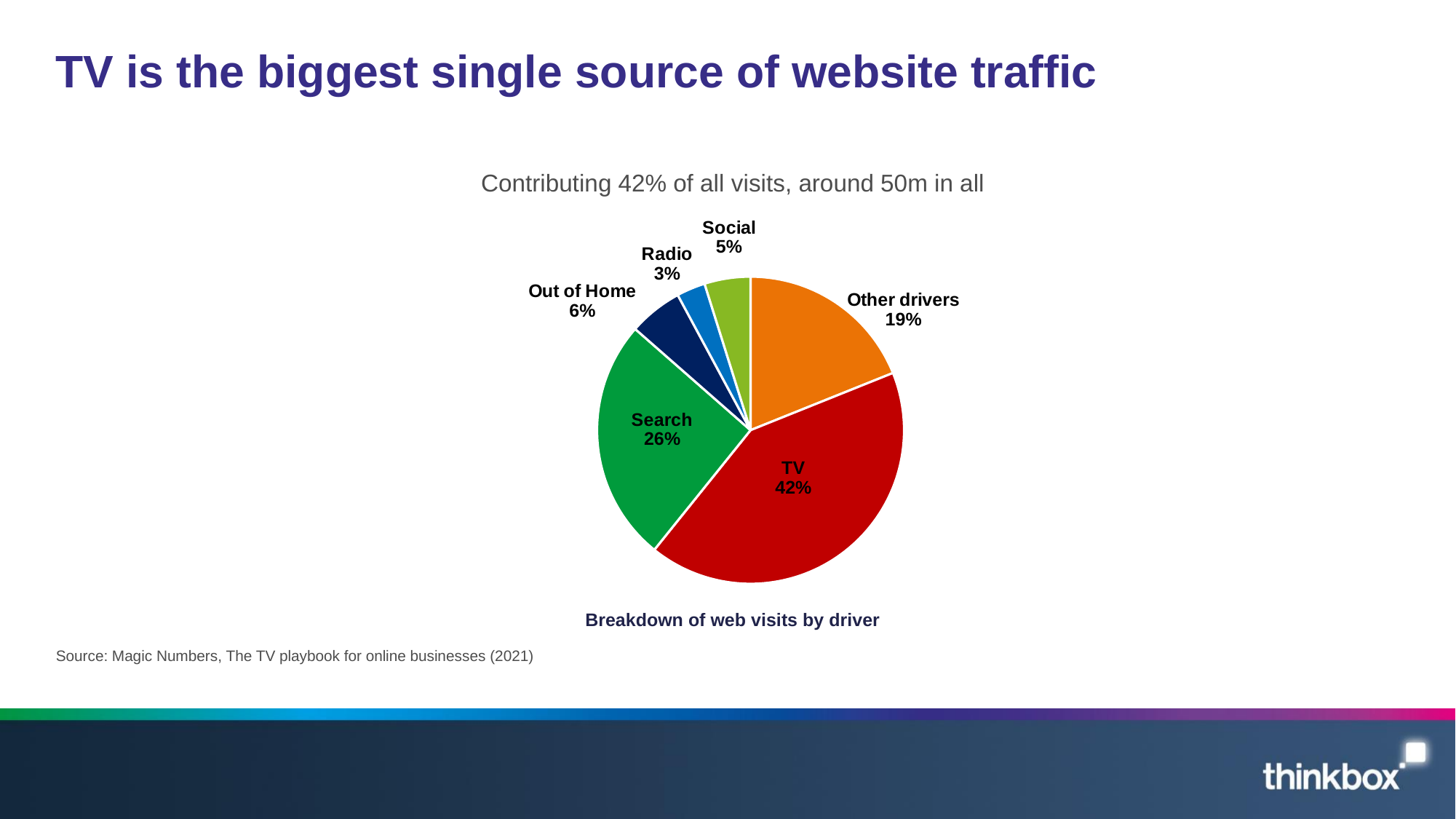
What share of web visits does TV account for? 42% What type of chart is used to show the breakdown of web visits by driver? Pie chart What is the difference in percentage points between TV and Search? 16 What percentage of web visits is driven by Radio? 3% What percentage of web visits is attributed to Search? 26% What share of web visits comes from Other drivers? 19% Which driver has the largest share of web visits? TV What is the title of the chart? Breakdown of web visits by driver Which driver has the smallest share of web visits? Radio What is the combined share of Out of Home, Radio and Social? 14% Which has a larger share of web visits, Out of Home or Social? Out of Home How many drivers are shown in the pie chart? 6